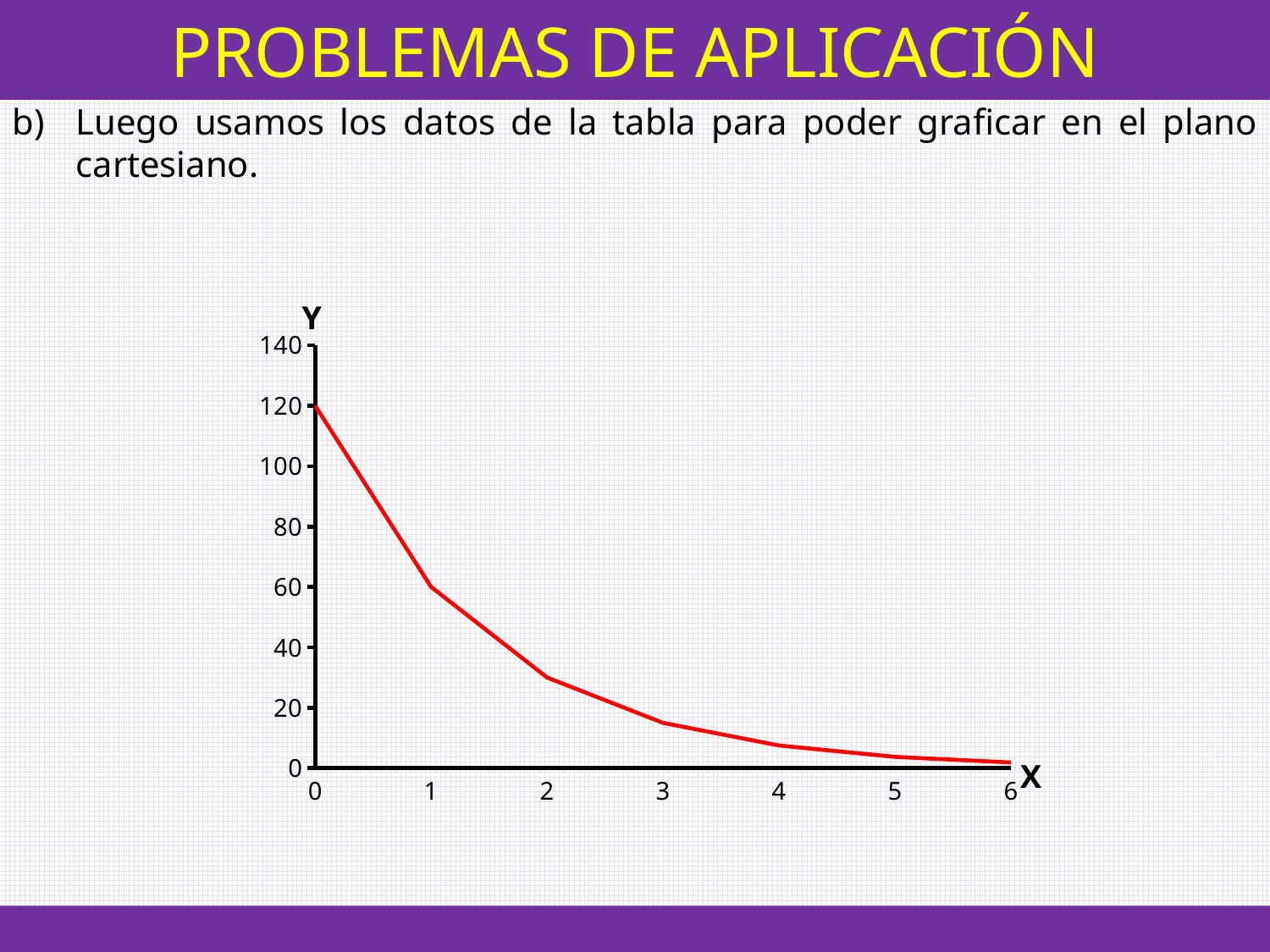
What is the value of Y when X is 0? 120 At which X value is Y highest? 0 At which X value is Y lowest? 6 What is the value of Y when X is 1? 60 Which is larger, the Y value at X = 1 or the Y value at X = 3? X = 1 Do the Y values rise or fall as X increases from 0 to 6? fall What is the highest value labeled on the Y axis? 140 Is the Y value at X = 2 greater or less than 40? less What is the difference between the Y value at X = 0 and the Y value at X = 1? 60 What kind of chart is shown on the slide? line chart Is the Y value at X = 4 greater or less than 20? less Is the Y value at X = 2 greater or less than 20? greater